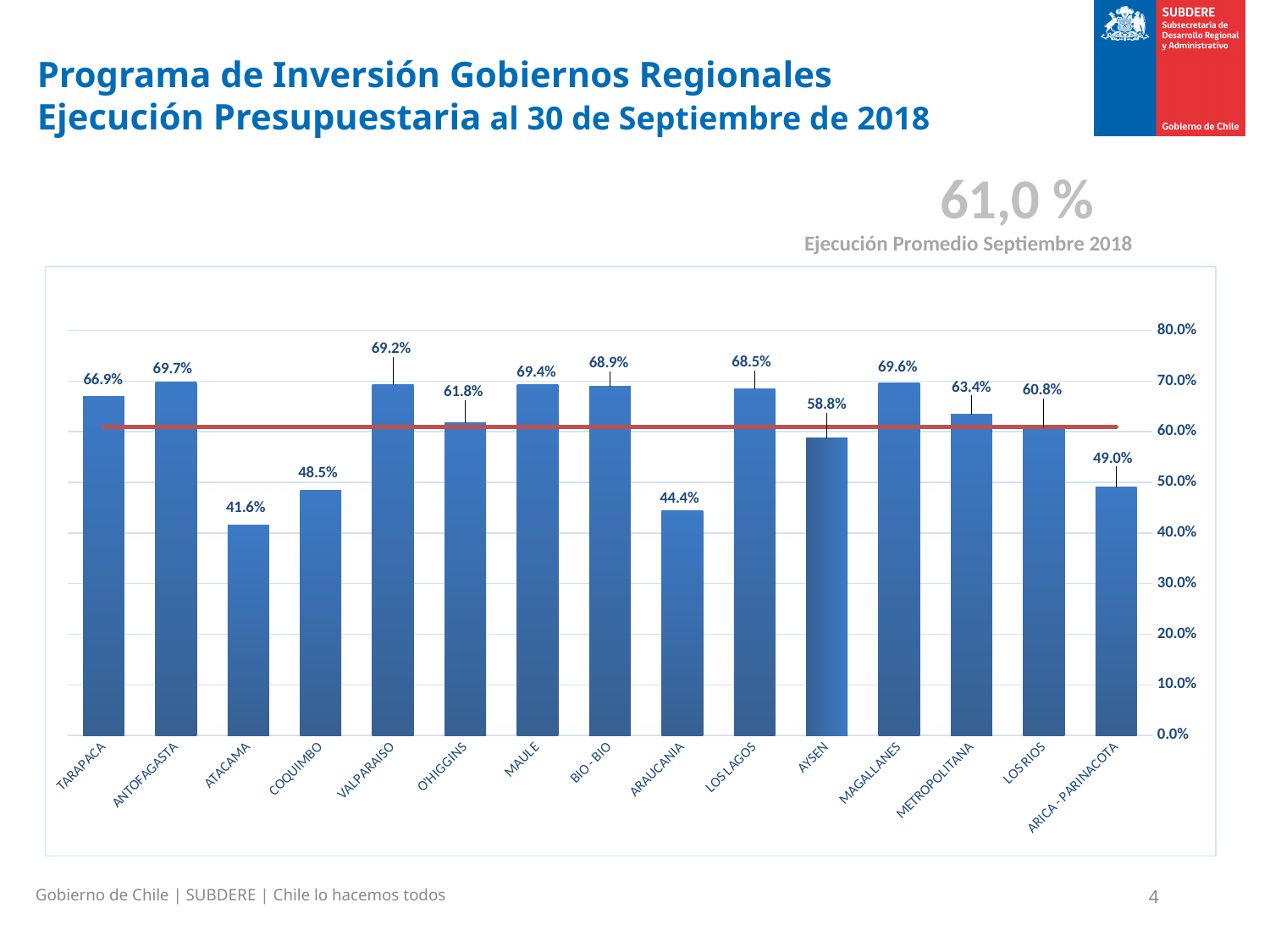
Which region has the lowest value? ATACAMA Is the value for ARAUCANIA greater or less than 50.0%? less What is the value for VALPARAISO? 69.2% What kind of chart is shown on the slide? bar chart Which is larger, the value for TARAPACA or the value for AYSEN? TARAPACA What is the value for METROPOLITANA? 63.4% What is the value for AYSEN? 58.8% How many regions are shown on the x axis? 15 What average execution value is shown above the chart for September 2018? 61,0 % What is the value for ARICA - PARINACOTA? 49.0% What is the difference between the values for ANTOFAGASTA and ATACAMA? 28.1 percentage points What is the difference between the values for MAULE and LOS RIOS? 8.6 percentage points